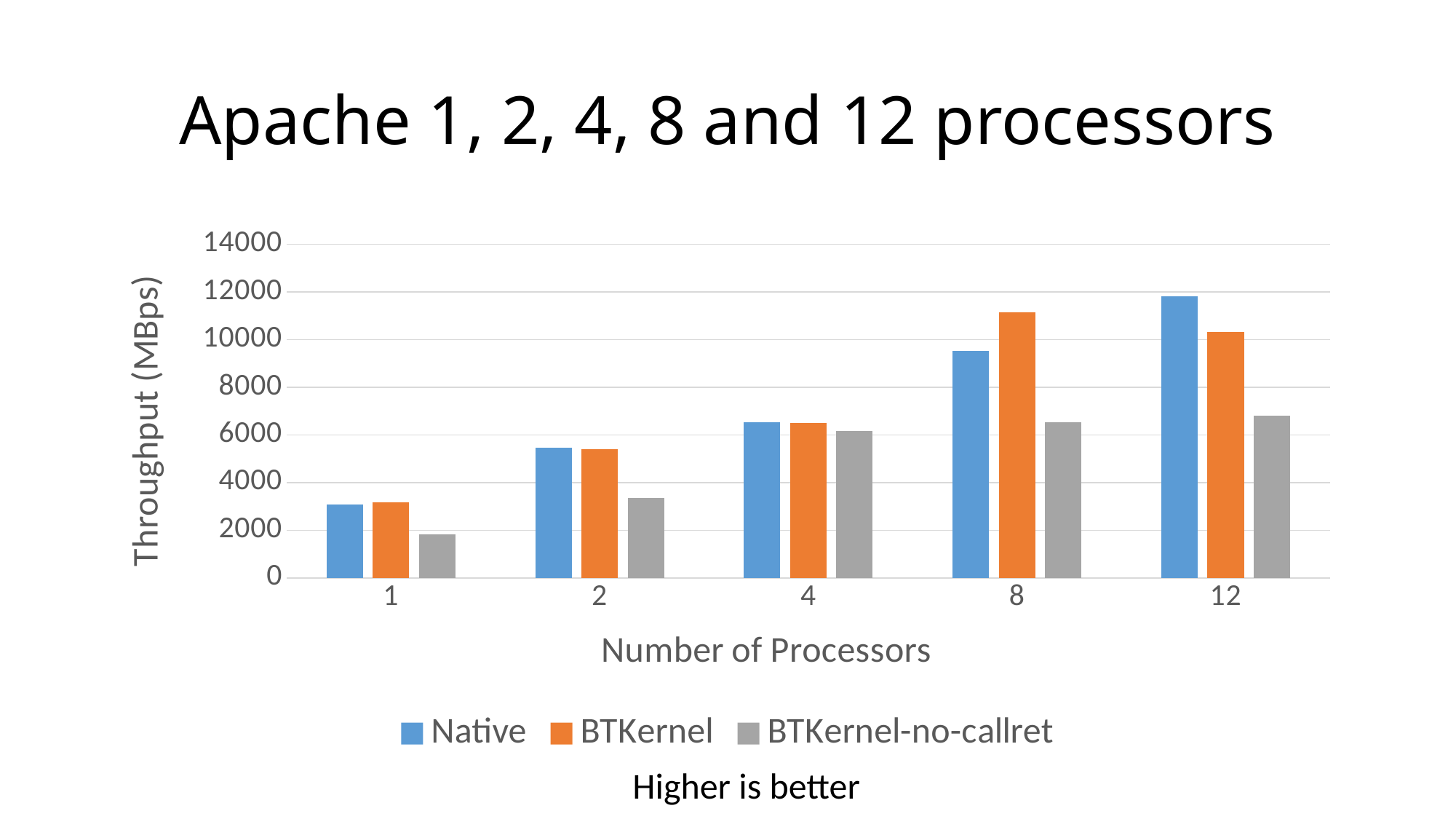
At which number of processors is the BTKernel-no-callret throughput lowest? 1 How many processor counts are shown along the x axis? 5 Does the Native throughput rise or fall as the number of processors increases? rise At 8 processors, which is larger: Native or BTKernel throughput? BTKernel At which number of processors is the Native throughput highest? 12 What kind of chart is shown on the slide? bar chart Is the Native throughput at 12 processors greater or less than 10000? greater Is the BTKernel-no-callret throughput at 1 processor greater or less than 2000? less What is the label of the y axis? Throughput (MBps) How many series does the legend list? 3 Is the BTKernel throughput at 8 processors greater or less than 10000? greater At 12 processors, which is larger: Native or BTKernel throughput? Native